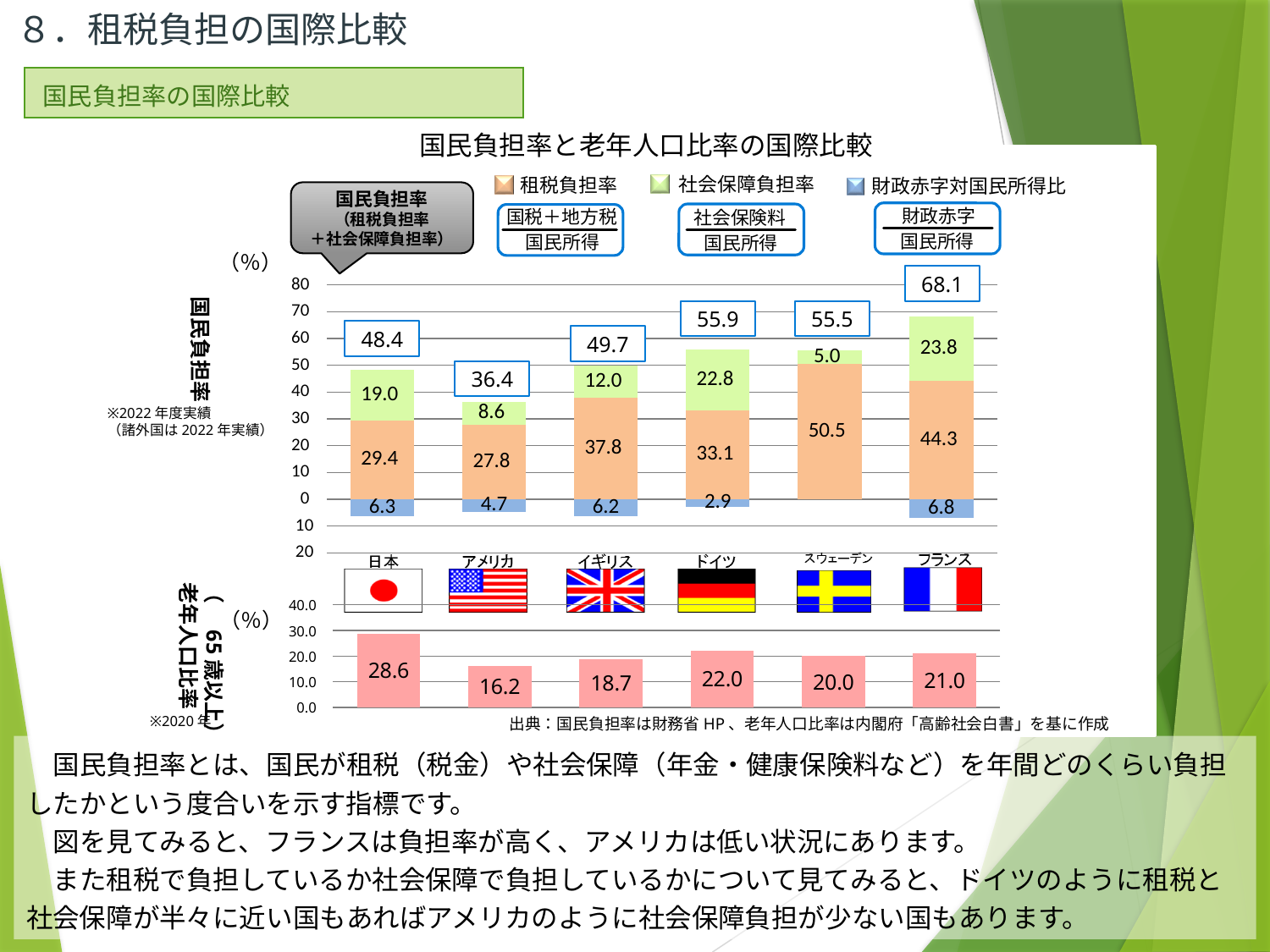
In the lower chart (老年人口比率), which is larger, the value for ドイツ or the value for スウェーデン? ドイツ In the lower chart (老年人口比率), which country has the lowest value? アメリカ In the lower chart (老年人口比率), what is the value for 日本? 28.6 In the upper chart (国民負担率), what is the 国民負担率 value shown for フランス? 68.1 How many countries are shown in the lower chart (老年人口比率)? 6 In the upper chart (国民負担率), what is the 財政赤字対国民所得比 value for 日本? 6.3 In the upper chart (国民負担率), which country has the lowest 国民負担率? アメリカ In the upper chart (国民負担率), what is the difference between the 国民負担率 of フランス and アメリカ? 31.7 In the upper chart (国民負担率), which country has the highest 租税負担率? スウェーデン In the upper chart (国民負担率), what is the 社会保障負担率 value for ドイツ? 22.8 In the upper chart (国民負担率), how many series does the legend list? 3 In the upper chart (国民負担率), what is the 租税負担率 value for イギリス? 37.8